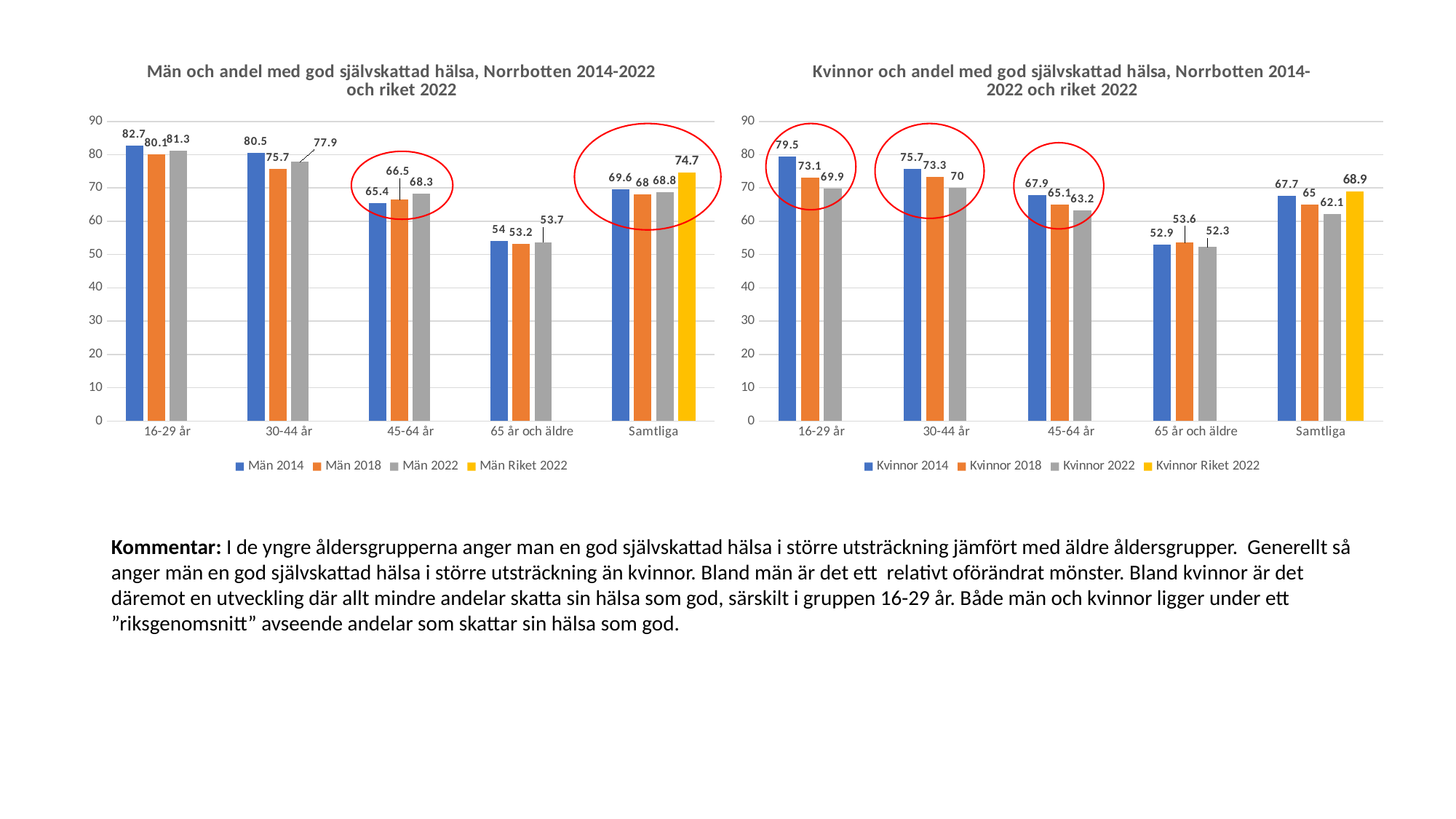
What type of chart is the left chart (Män och andel med god självskattad hälsa)? Bar chart In the left chart (Män), which is larger in the 45-64 år group: Män 2014 or Män 2022? Män 2022 In the right chart (Kvinnor), what is the difference between Kvinnor 2014 and Kvinnor 2022 in the 16-29 år group? 9.6 In the right chart (Kvinnor), which age group has the lowest value for Kvinnor 2014? 65 år och äldre In the right chart (Kvinnor och andel med god självskattad hälsa), what is the value for Kvinnor 2022 in the 16-29 år group? 69.9 In the right chart (Kvinnor), is the value for Kvinnor Riket 2022 in the Samtliga group greater or less than 60? greater In the left chart (Män), which age group has the highest value for Män 2022? 16-29 år In the right chart (Kvinnor), do the Kvinnor 2014 values rise or fall from 16-29 år to 65 år och äldre? Fall In the left chart (Män och andel med god självskattad hälsa), what is the value for Män 2014 in the 16-29 år group? 82.7 How many age-group categories are shown on the x axis of the left chart (Män)? 5 In the left chart (Män), what is the value for Män Riket 2022 in the Samtliga group? 74.7 How many series does the legend of the right chart (Kvinnor) list? 4